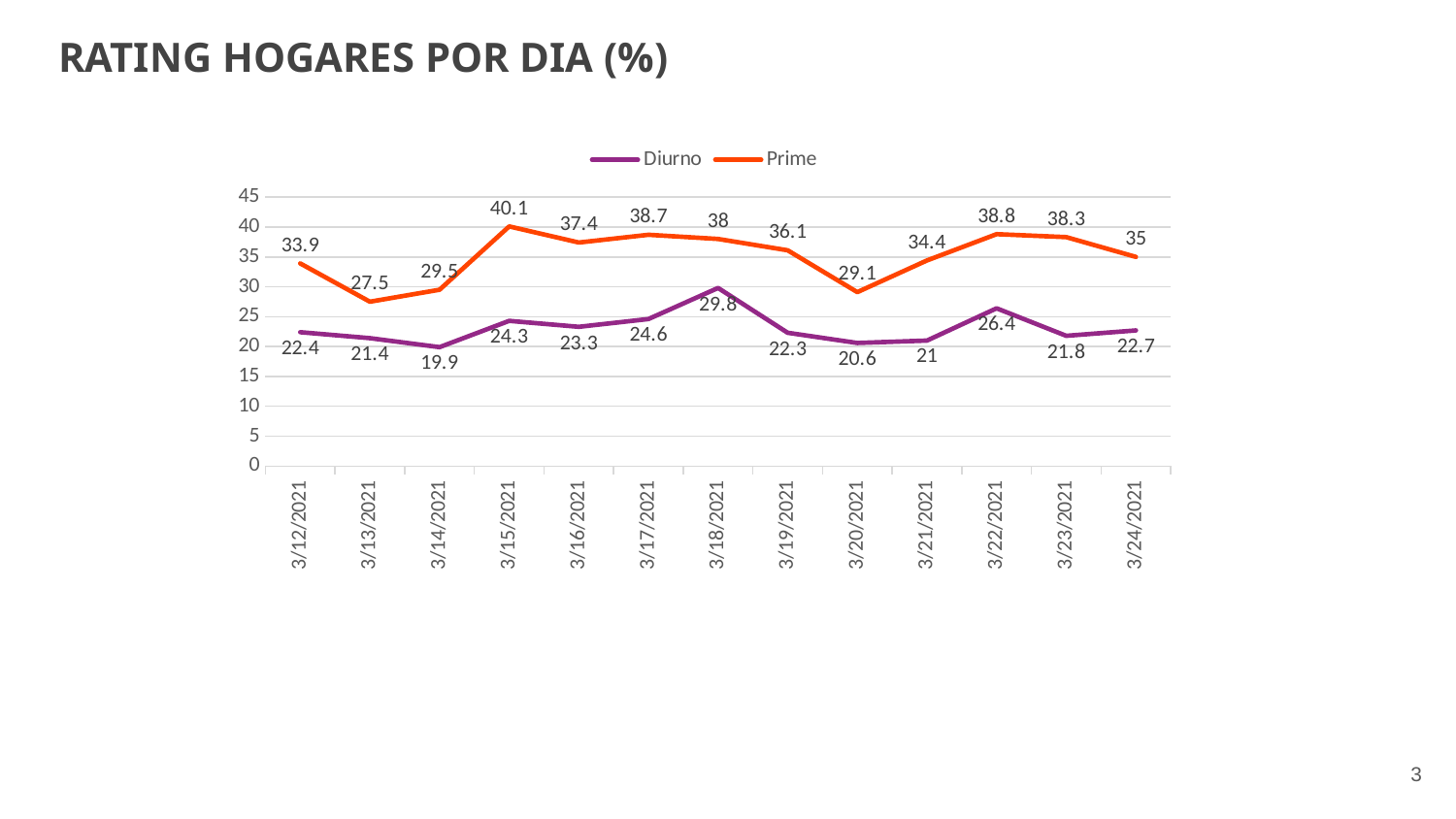
Is the Prime value on 3/20/2021 greater or less than 30? less What is the difference between the Prime and Diurno values on 3/24/2021? 12.3 On which date is the Diurno value highest? 3/18/2021 How many dates are plotted along the x axis? 13 Does the Prime value rise or fall from 3/22/2021 to 3/24/2021? fall What type of chart is shown on the slide? line chart On which date is the Prime value lowest? 3/13/2021 What is the Prime value on 3/15/2021? 40.1 What is the title of the chart? RATING HOGARES POR DIA (%) Which is larger, the Diurno value on 3/22/2021 or the Diurno value on 3/23/2021? 3/22/2021 What is the Diurno value on 3/20/2021? 20.6 How many series does the legend list? 2